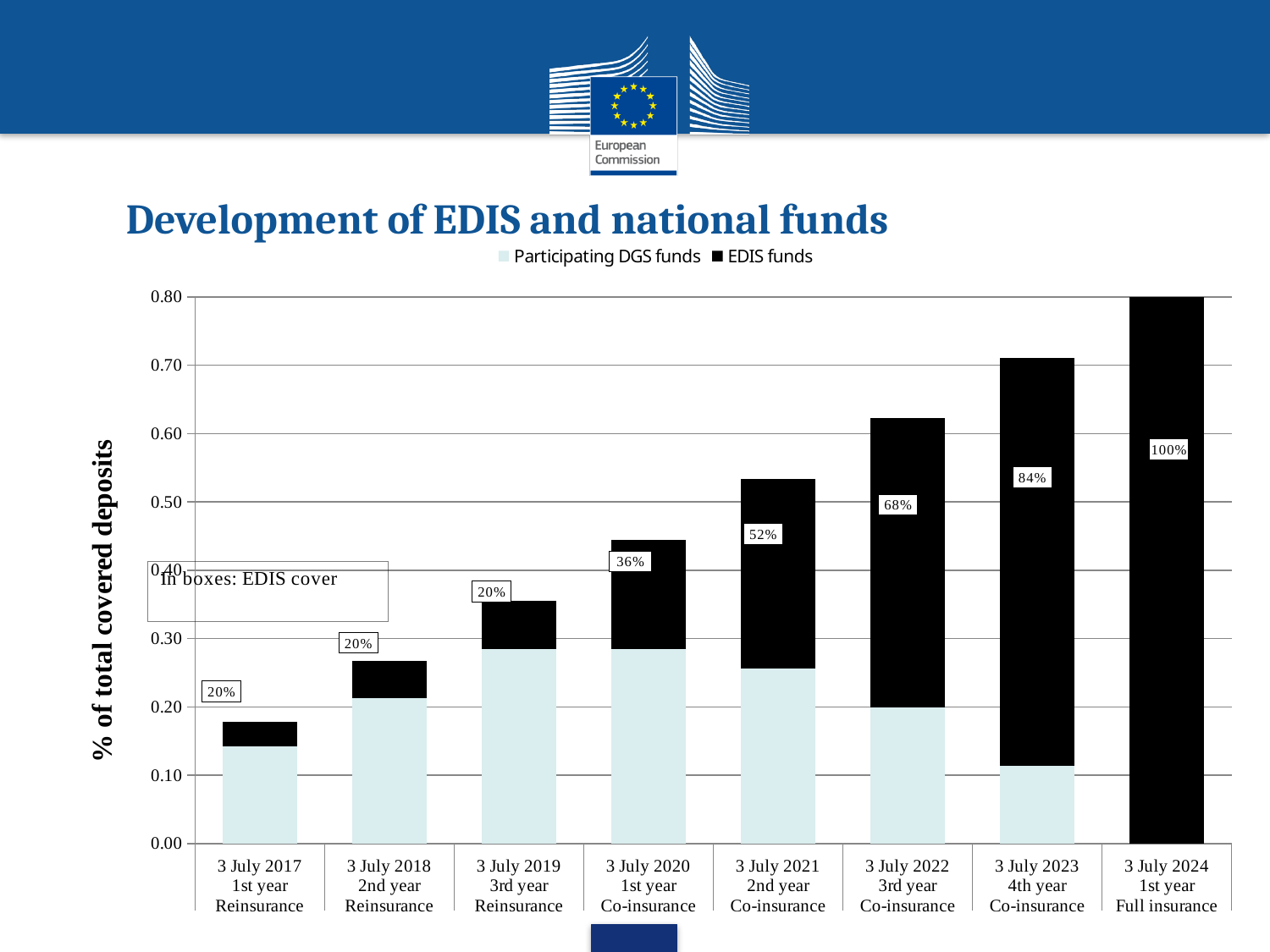
Which date has the lowest total stacked bar? 3 July 2017 What EDIS cover percentage is shown in the box for 3 July 2020? 36% Is the total stacked bar for 3 July 2017 greater or less than 0.20? less What EDIS cover percentage is shown in the box for 3 July 2023? 84% How many dates (categories) are shown along the x axis? 8 What is the title of the chart? Development of EDIS and national funds What kind of chart is shown on the slide? bar chart Which date has the highest total stacked bar? 3 July 2024 Is the total stacked bar for 3 July 2023 greater or less than 0.70? greater Do the total stacked bar heights rise or fall from 3 July 2017 to 3 July 2024? rise What EDIS cover percentage is shown in the box for 3 July 2024? 100% How many series does the legend list? 2